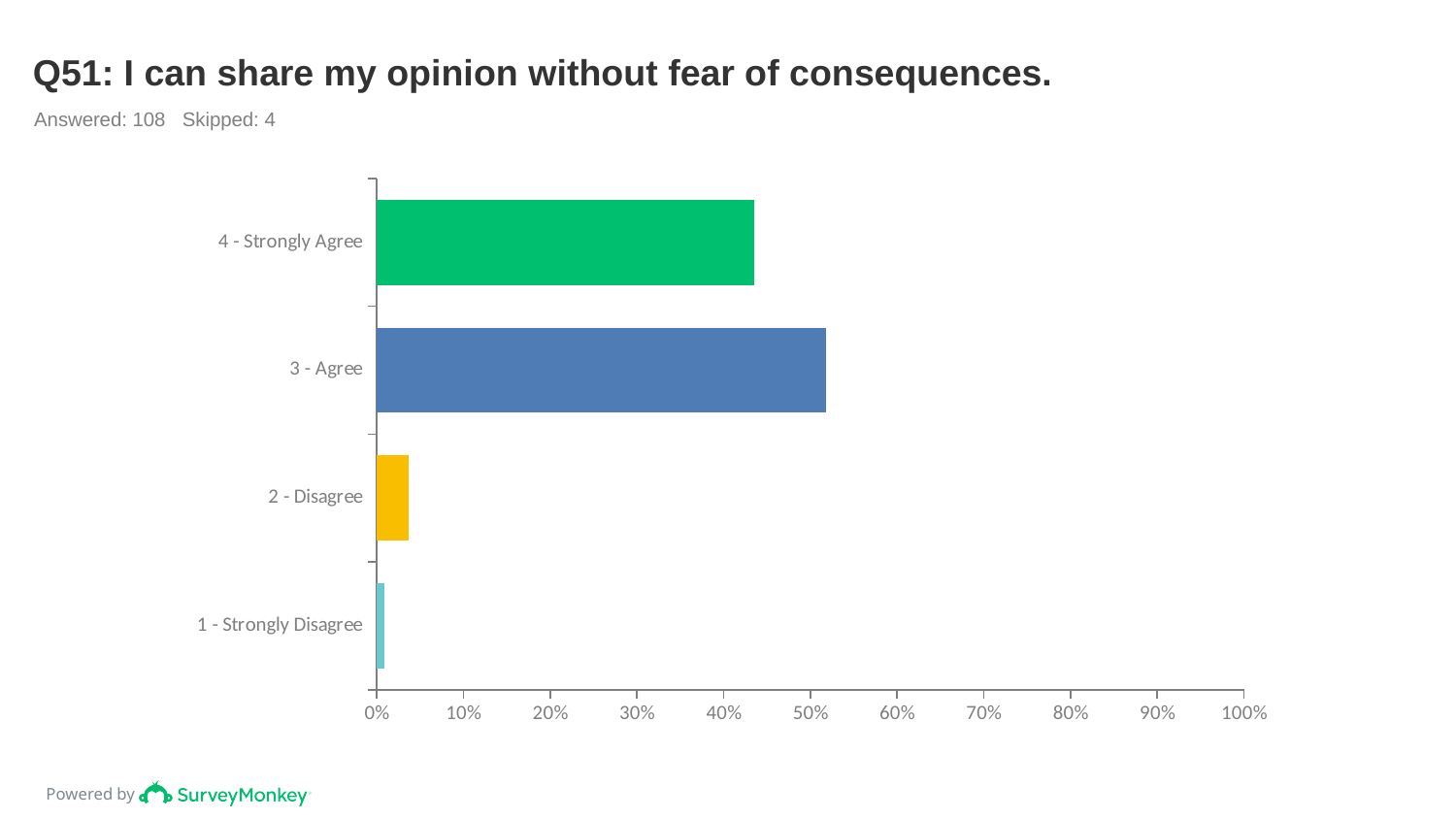
What is the title of the chart? Q51: I can share my opinion without fear of consequences. Is the value for 3 - Agree greater or less than 50%? greater Is the value for 4 - Strongly Agree greater or less than 50%? less Which is larger, the value for 3 - Agree or the value for 4 - Strongly Agree? 3 - Agree How many categories are plotted in the chart? 4 Which category has the highest value? 3 - Agree Which category has the lowest value? 1 - Strongly Disagree Is the value for 2 - Disagree greater or less than 10%? less What kind of chart is shown on the slide? bar chart How many respondents answered the question according to the slide? 108 Which is larger, the value for 2 - Disagree or the value for 1 - Strongly Disagree? 2 - Disagree